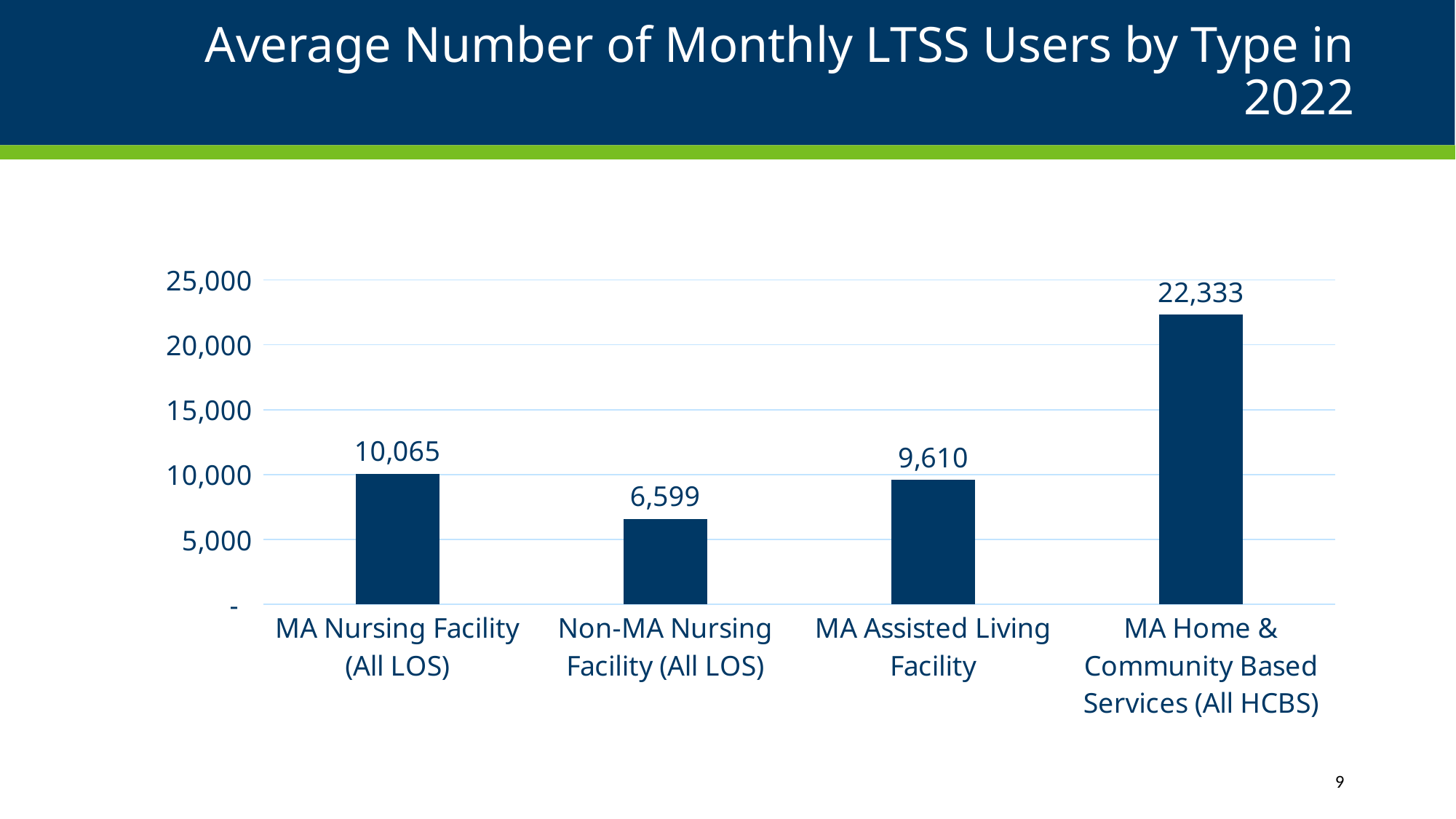
What is the difference between the values for MA Home & Community Based Services (All HCBS) and MA Nursing Facility (All LOS)? 12,268 Is the value for MA Home & Community Based Services (All HCBS) greater or less than 20,000? greater What kind of chart is shown on the slide? Bar chart What is the average number of monthly LTSS users for MA Nursing Facility (All LOS)? 10,065 Which category has the highest average number of monthly LTSS users? MA Home & Community Based Services (All HCBS) Which category has the lowest average number of monthly LTSS users? Non-MA Nursing Facility (All LOS) What is the difference between the values for MA Nursing Facility (All LOS) and Non-MA Nursing Facility (All LOS)? 3,466 How many categories are shown in the chart? 4 Which is larger, the value for MA Nursing Facility (All LOS) or MA Assisted Living Facility? MA Nursing Facility (All LOS) What is the value shown for MA Home & Community Based Services (All HCBS)? 22,333 What is the value shown for MA Assisted Living Facility? 9,610 What is the value shown for Non-MA Nursing Facility (All LOS)? 6,599